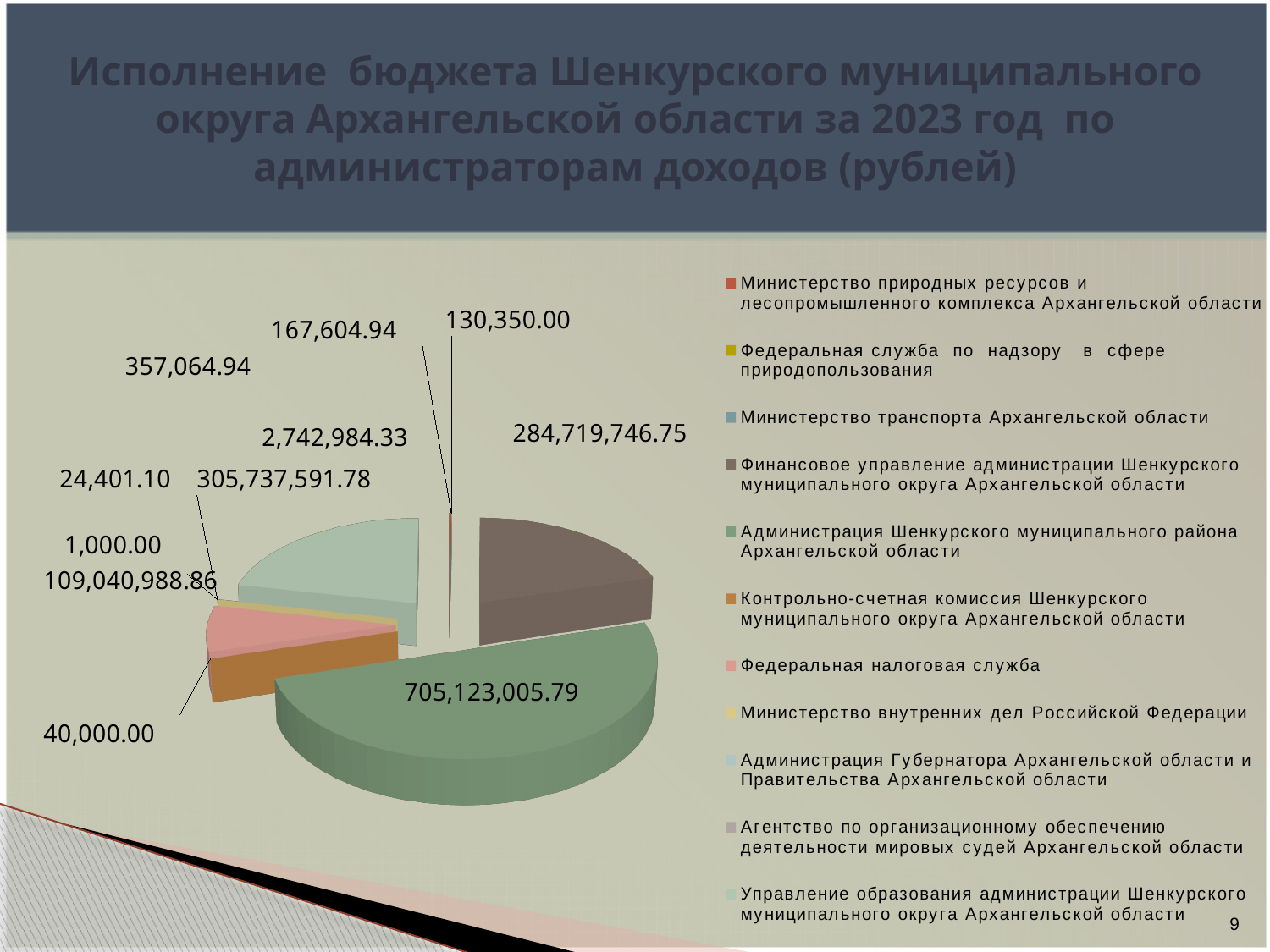
What is the smallest value labelled on the pie chart? 1,000.00 What is the value for Федеральная налоговая служба? 109,040,988.86 What is the value for Управление образования администрации Шенкурского муниципального округа Архангельской области? 305,737,591.78 What is the difference between the value for Администрация Шенкурского муниципального района (705,123,005.79) and the value for Финансовое управление (284,719,746.75)? 420,403,259.04 Which is larger: the value for Финансовое управление администрации Шенкурского муниципального округа or the value for Управление образования администрации Шенкурского муниципального округа? Управление образования администрации Шенкурского муниципального округа Архангельской области Which revenue administrator has the largest slice of the pie? Администрация Шенкурского муниципального района Архангельской области What is the difference between the value for Управление образования (305,737,591.78) and the value for Финансовое управление (284,719,746.75)? 21,017,845.03 What type of chart is shown on the slide? Pie chart What is the value for Администрация Шенкурского муниципального района Архангельской области? 705,123,005.79 What is the value for Финансовое управление администрации Шенкурского муниципального округа Архангельской области? 284,719,746.75 What year does the chart title say the budget execution data is for? 2023 How many revenue administrators (categories) does the legend list? 11